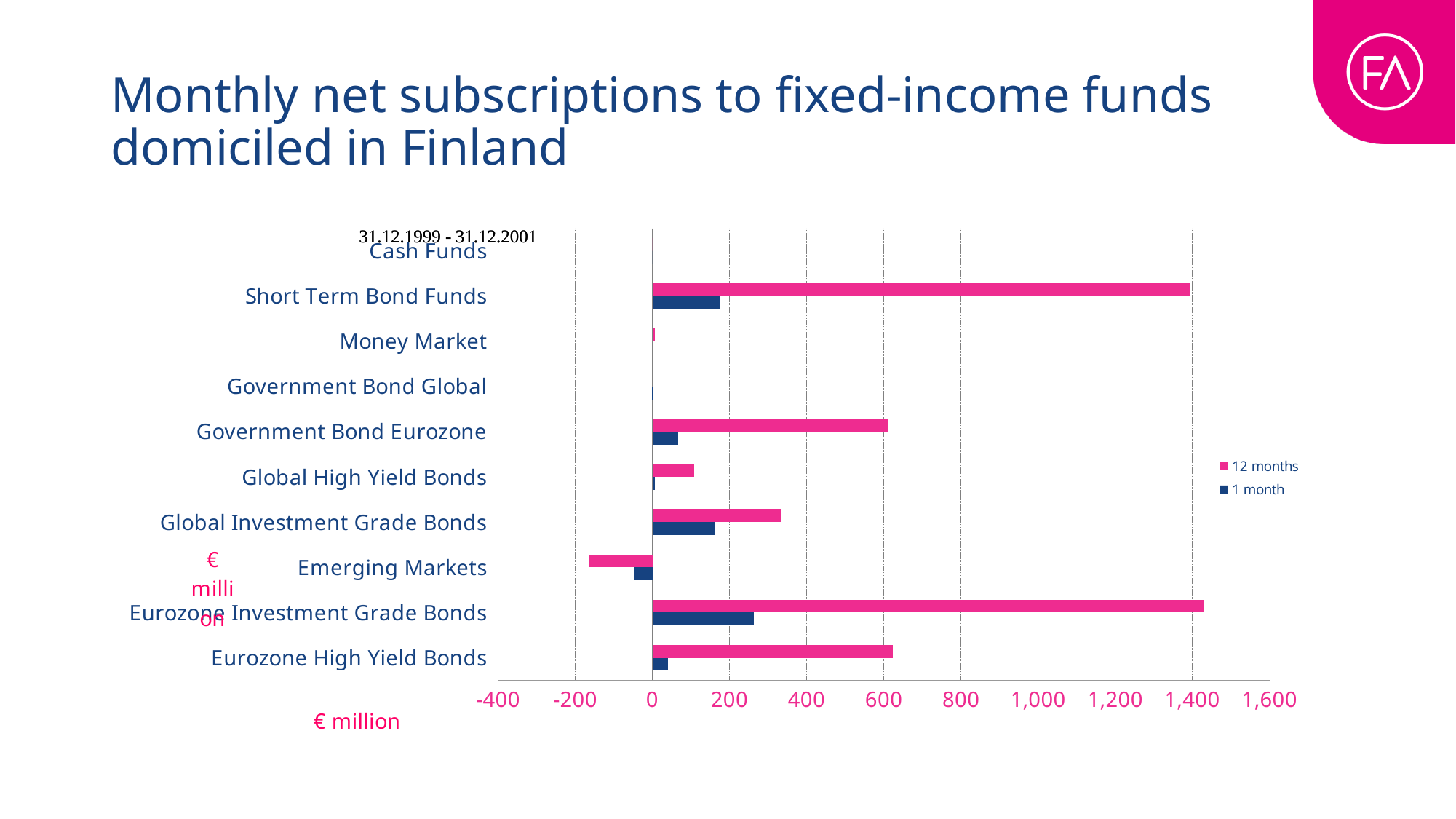
What unit is shown on the horizontal axis of the chart? € million Which category has the lowest 12 months value? Emerging Markets Which is larger for the 12 months series: Government Bond Eurozone or Global High Yield Bonds? Government Bond Eurozone Is the 12 months value for Emerging Markets greater or less than -100? less Which category has the lowest 1 month value? Emerging Markets How many series does the legend list? 2 How many fund categories are shown on the vertical axis? 10 Which is larger for the 1 month series: Short Term Bond Funds or Government Bond Eurozone? Short Term Bond Funds What kind of chart is shown on the slide? bar chart Is the 12 months value for Short Term Bond Funds greater or less than 1,200? greater Is the 12 months value for Global Investment Grade Bonds greater or less than 200? greater Which category has the highest 1 month value? Eurozone Investment Grade Bonds